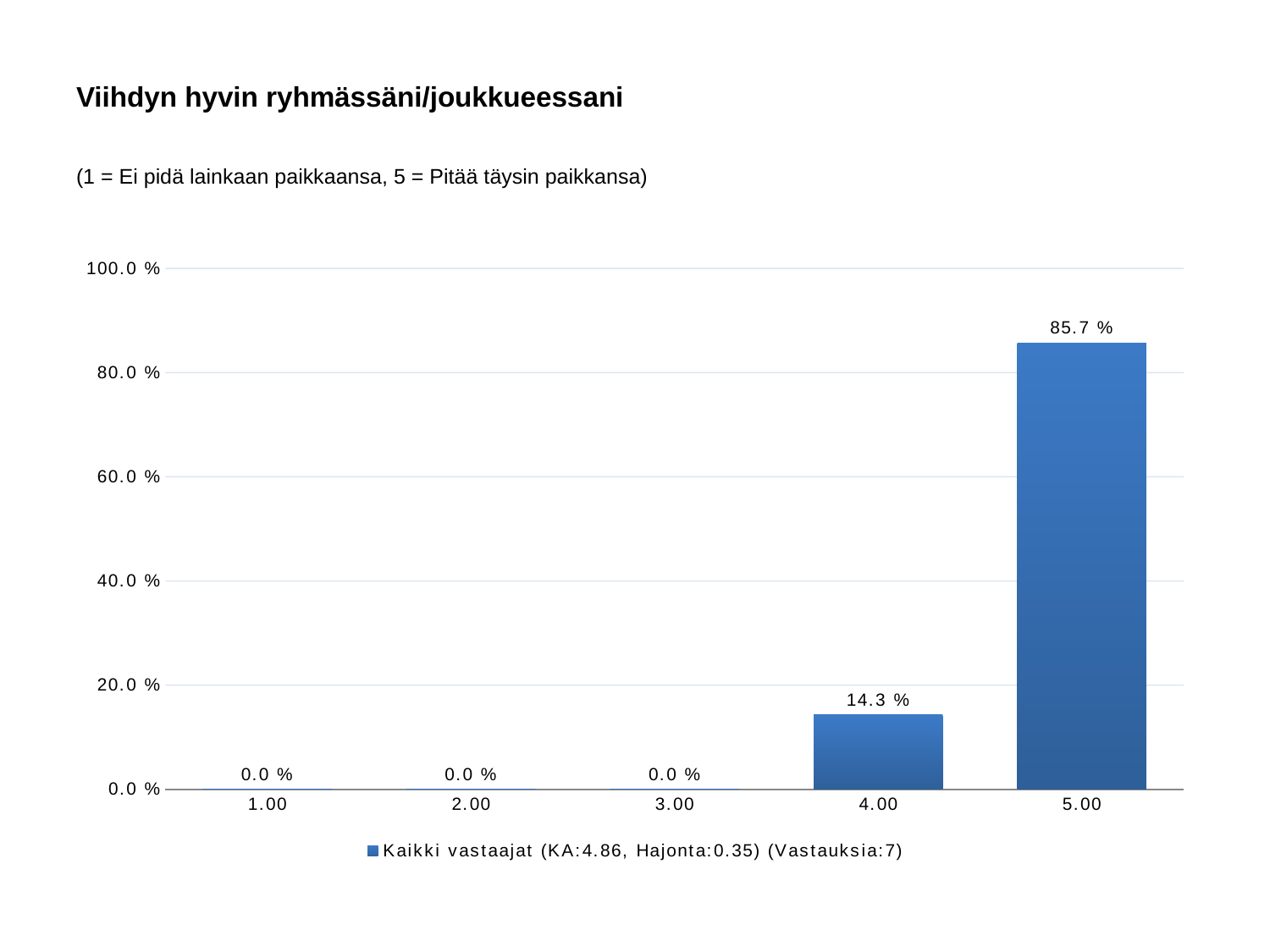
What is the title of the chart? Viihdyn hyvin ryhmässäni/joukkueessani What is the value for category 4.00? 14.3 % How many categories are shown on the x axis? 5 What kind of chart is shown? bar chart How many series does the legend list? 1 What is the difference between the values for 5.00 and 4.00? 71.4 % Is the value for 5.00 greater or less than 80.0 %? greater Which is larger, the value for 4.00 or the value for 5.00? 5.00 Is the value for 4.00 greater or less than 20.0 %? less Which category has the highest value? 5.00 What is the value for category 5.00? 85.7 % What is the value for category 1.00? 0.0 %